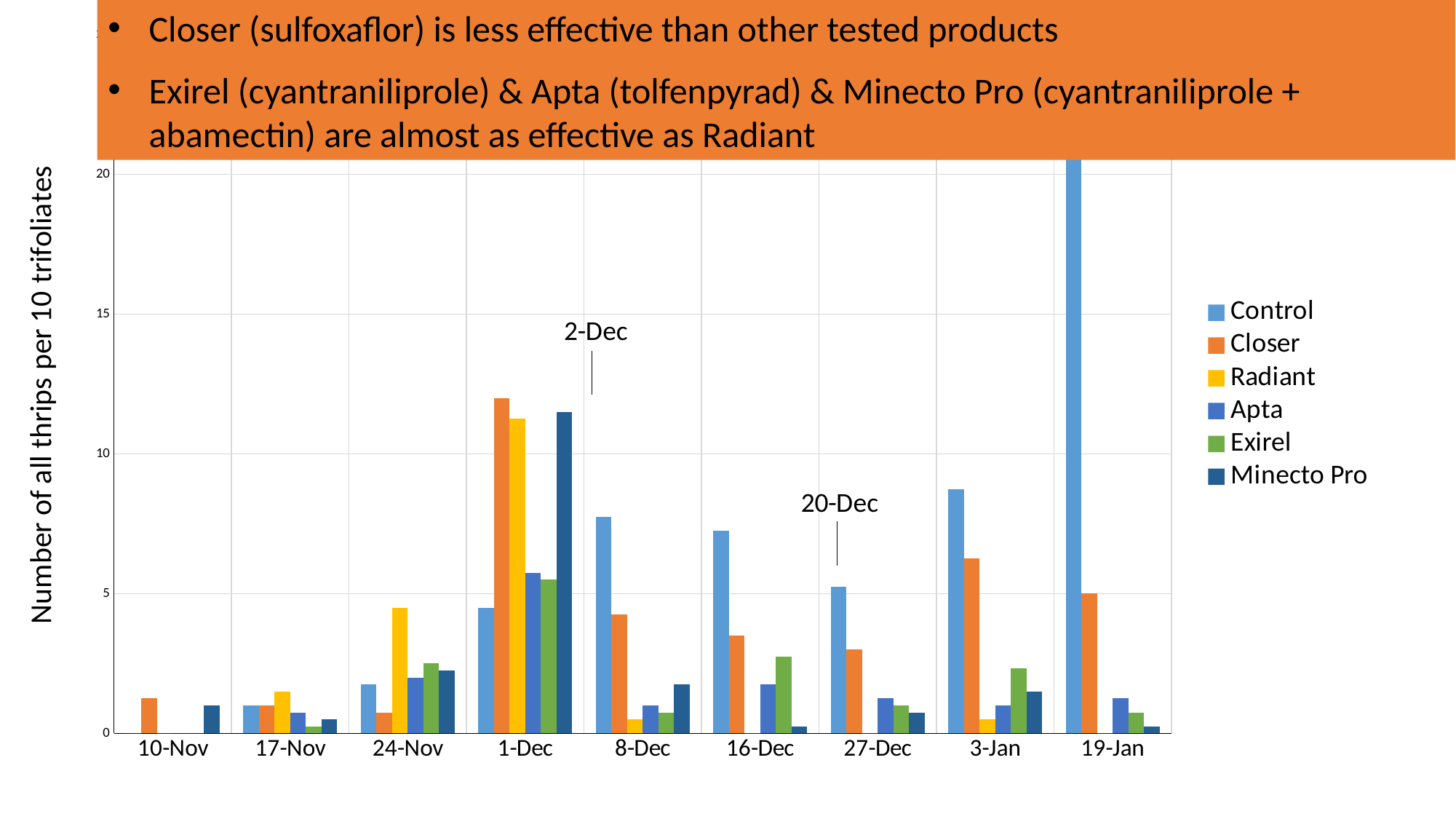
Does the Control value rise or fall from 8-Dec to 27-Dec? fall Is the value for Control on 19-Jan greater or less than 20? greater Is the value for Control on 1-Dec greater or less than 5? less How many dates are shown along the x axis? 9 What is the label on the y axis? Number of all thrips per 10 trifoliates Is the value for Closer on 1-Dec greater or less than 10? greater What kind of chart is shown on the slide? bar chart On 8-Dec, which is larger, the Control value or the Closer value? Control On which date is the Control bar highest? 19-Jan How many series does the legend list? 6